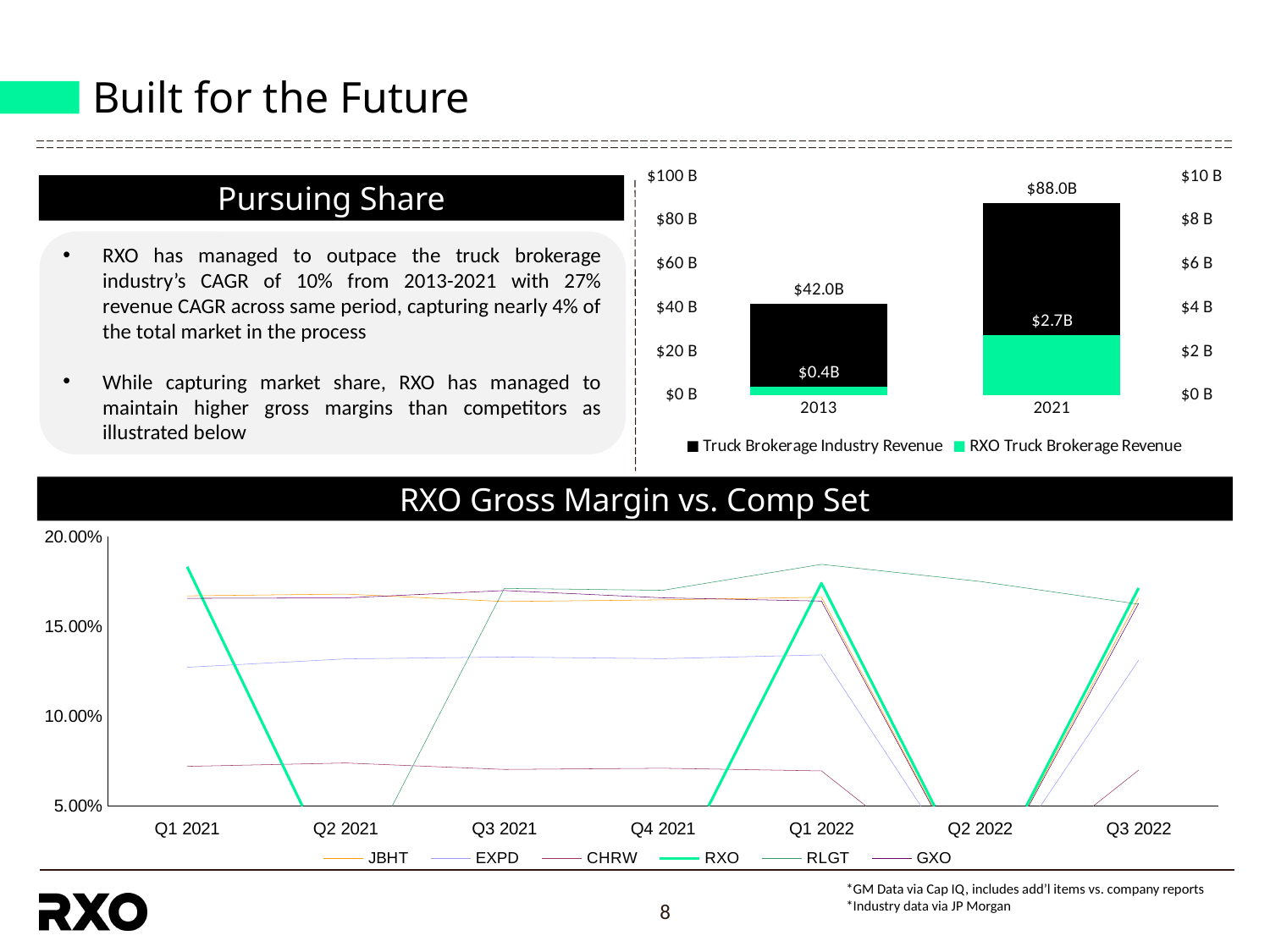
In the 'RXO Gross Margin vs. Comp Set' chart, how many quarters are shown on the x axis? 7 In the top-right bar chart, by how much did Truck Brokerage Industry Revenue grow from 2013 to 2021? $46.0B In the top-right bar chart, how many series does the legend list? 2 In the top-right bar chart, what is the RXO Truck Brokerage Revenue for 2021? $2.7B What kind of chart is the top-right chart showing Truck Brokerage Industry Revenue? Bar chart In the top-right bar chart, what is the Truck Brokerage Industry Revenue for 2013? $42.0B In the 'RXO Gross Margin vs. Comp Set' chart, is the value for RXO in Q1 2021 greater or less than 15.00%? greater In the top-right bar chart, what is the RXO Truck Brokerage Revenue for 2013? $0.4B In the top-right bar chart, what is the Truck Brokerage Industry Revenue for 2021? $88.0B In the top-right bar chart, what is the difference between RXO Truck Brokerage Revenue in 2021 and 2013? $2.3B In the 'RXO Gross Margin vs. Comp Set' chart, which series has the lowest value in Q1 2021? CHRW In the 'RXO Gross Margin vs. Comp Set' chart, how many series does the legend list? 6